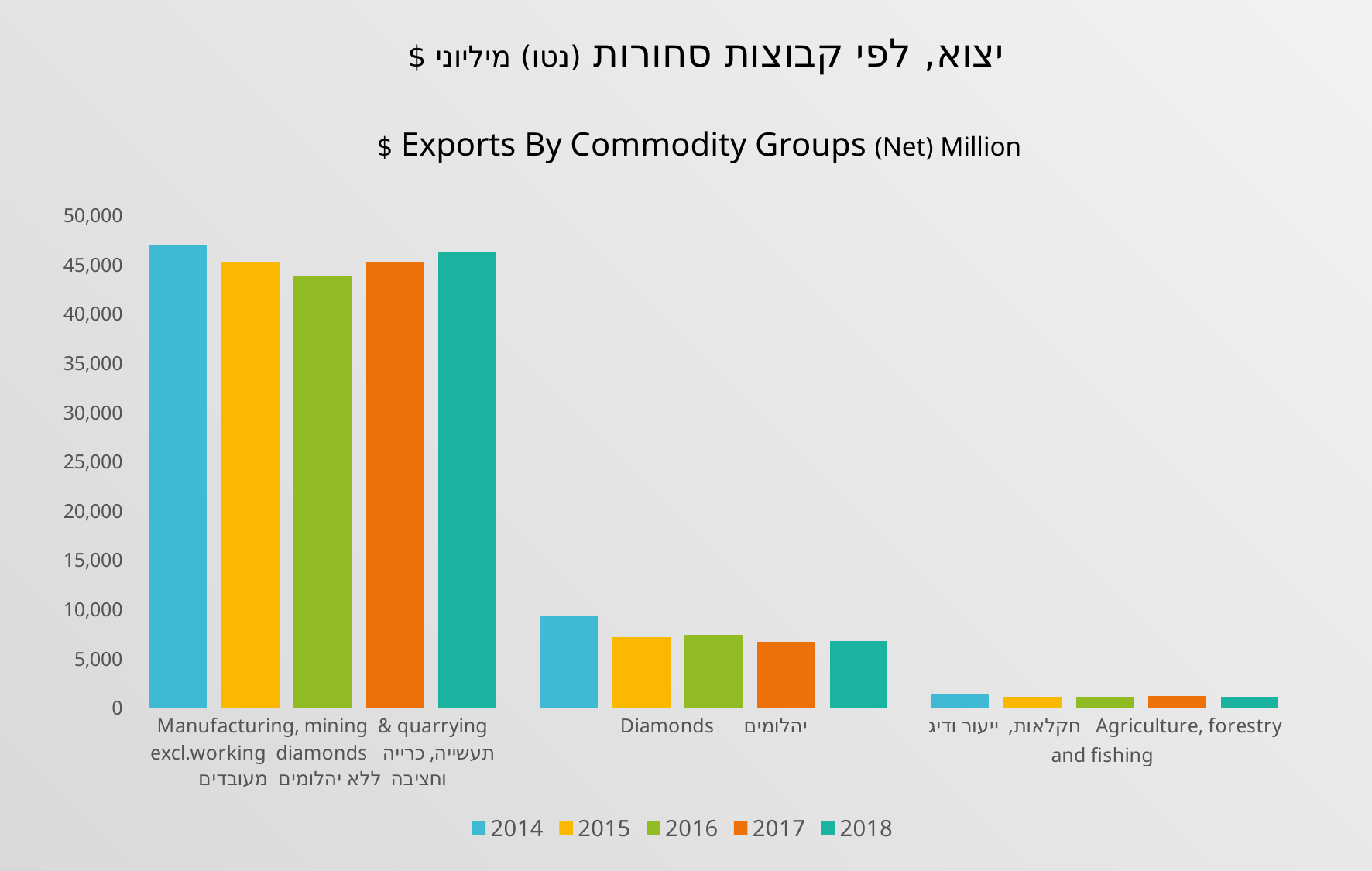
Which commodity group has the highest export values? Manufacturing, mining & quarrying excl. working diamonds Which commodity group has the lowest export values? Agriculture, forestry and fishing Is the 2014 value for Manufacturing, mining & quarrying excl. working diamonds greater or less than 45,000? greater Which colour represents the 2017 series in the legend? orange For Diamonds, which year has the larger value, 2014 or 2015? 2014 What kind of chart is shown on the slide? bar chart How many commodity groups are shown on the x axis? 3 Is the 2015 value for Diamonds greater or less than 5,000? greater Is the 2016 value for Manufacturing, mining & quarrying excl. working diamonds greater or less than 45,000? less How many series does the legend list? 5